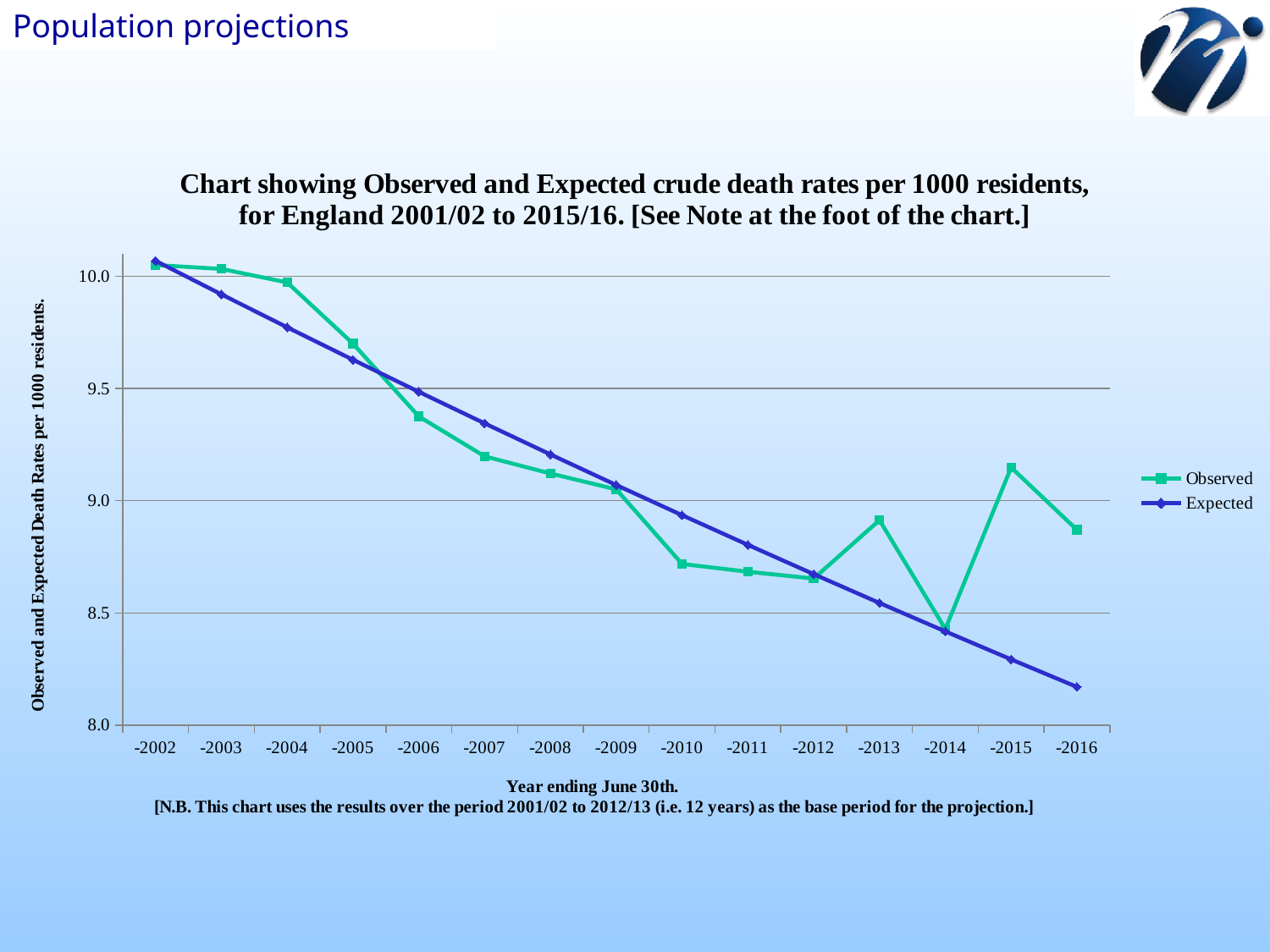
How many series does the legend list? 2 In which year is the Observed series at its lowest? -2014 Is the Observed value for -2015 greater or less than 9.0? greater In -2015, which series has the higher value, Observed or Expected? Observed What kind of chart is shown on the slide? Line chart What colour is the line for the Observed series? Green In which year is the Expected series at its lowest? -2016 How many years are plotted along the x axis? 15 Is the Expected value for -2016 greater or less than 8.5? less Is the Observed value for -2010 greater or less than 9.0? less In -2006, which series has the higher value, Observed or Expected? Expected Does the Expected series rise or fall from -2002 to -2016? Fall